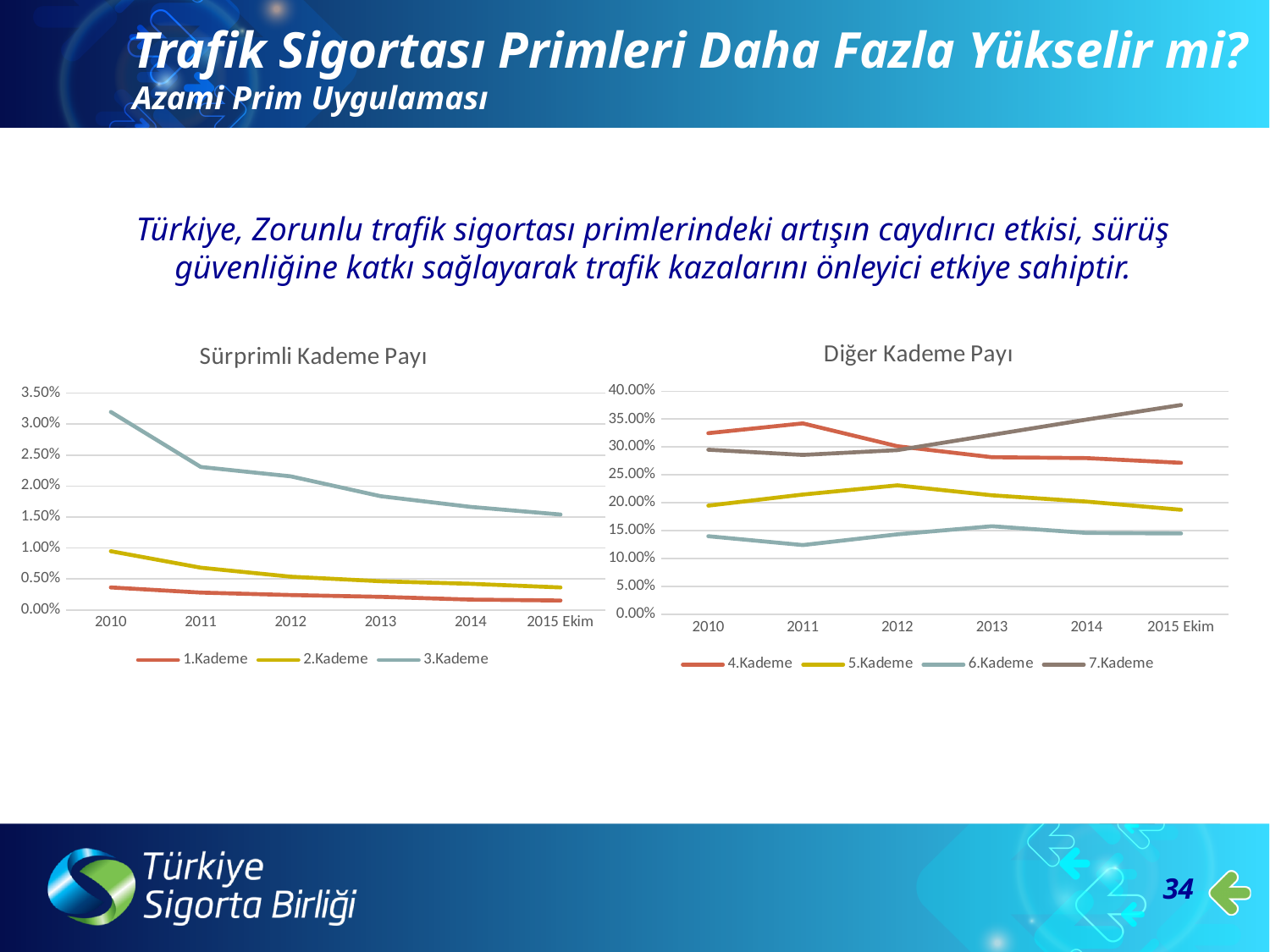
How many points are plotted along the x axis of the 'Diğer Kademe Payı' chart? 6 How many series does the legend of the 'Sürprimli Kademe Payı' chart list? 3 In the 'Sürprimli Kademe Payı' chart, which is larger in 2012: 2.Kademe or 1.Kademe? 2.Kademe In the 'Sürprimli Kademe Payı' chart, is the value for 3.Kademe in 2010 greater or less than 3.00%? greater In the 'Diğer Kademe Payı' chart, which series has the highest value in 2015 Ekim? 7.Kademe How many series does the legend of the 'Diğer Kademe Payı' chart list? 4 In the 'Diğer Kademe Payı' chart, is the value for 6.Kademe in 2011 greater or less than 15.00%? less In the 'Sürprimli Kademe Payı' chart, does the 3.Kademe line rise or fall from 2010 to 2015 Ekim? fall In the 'Diğer Kademe Payı' chart, which series has the lowest value in 2010? 6.Kademe What type of chart is the 'Sürprimli Kademe Payı' chart? line chart In the 'Diğer Kademe Payı' chart, does the 7.Kademe line rise or fall from 2011 to 2015 Ekim? rise In the 'Diğer Kademe Payı' chart, is the value for 7.Kademe in 2015 Ekim greater or less than 35.00%? greater